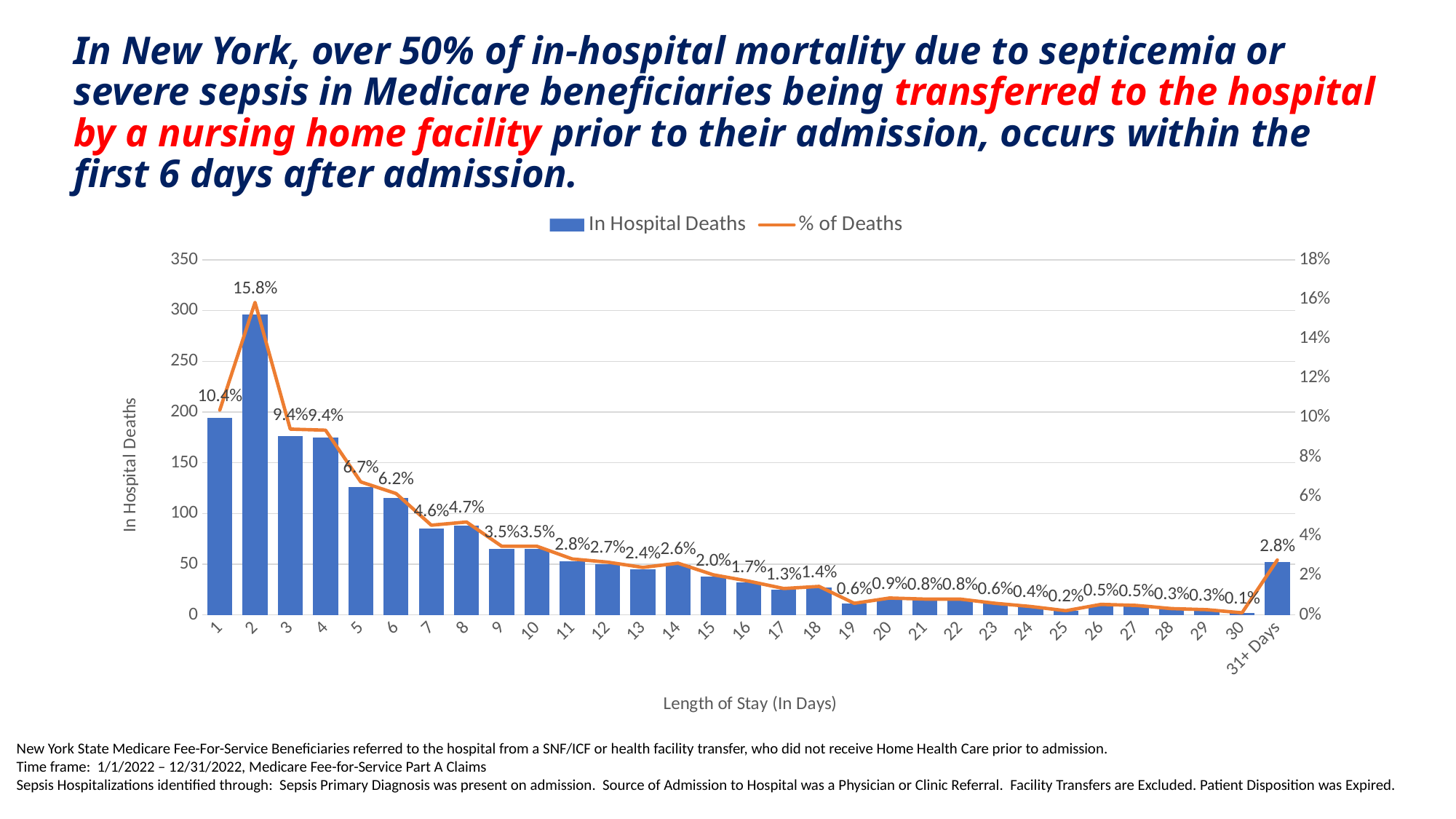
Which length of stay has the highest % of Deaths? 2 What is the % of Deaths value for a length of stay of 2 days? 15.8% How many length-of-stay categories are shown on the x axis? 31 Which length of stay has the lowest % of Deaths? 30 What is the % of Deaths value for a length of stay of 6 days? 6.2% What kind of chart is shown on the slide? Combined bar and line chart Is the In Hospital Deaths value for a length of stay of 2 days greater or less than 250? greater Does the % of Deaths generally rise or fall from day 2 to day 30? fall What is the % of Deaths value for a length of stay of 31+ Days? 2.8% What is the difference in % of Deaths between a length of stay of 2 days and 1 day? 5.4% Which has a larger % of Deaths, a length of stay of 5 days or 7 days? 5 days How many series does the legend list? 2